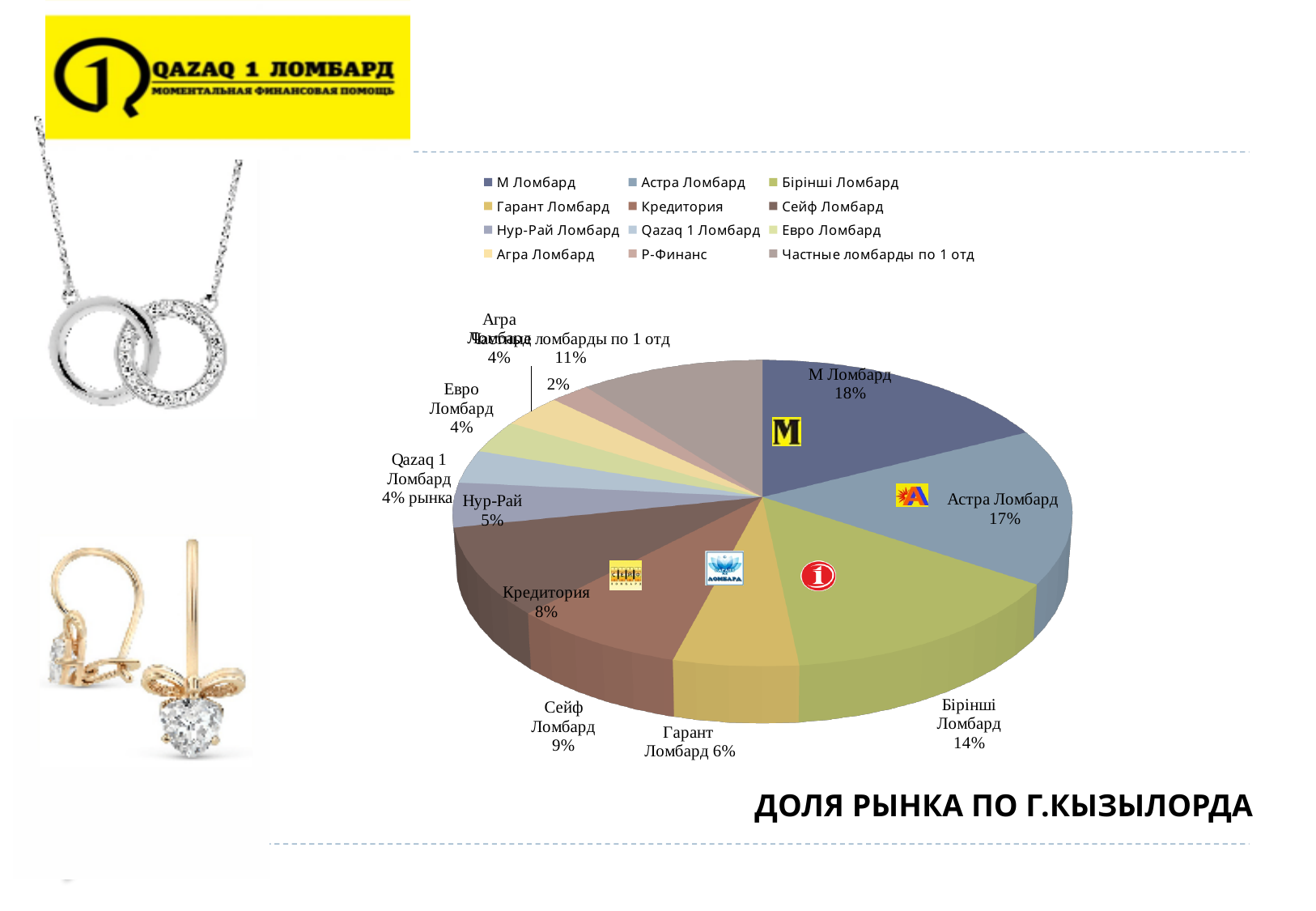
How many entries does the legend list? 12 What is the market share of Астра Ломбард? 17% What is the market share of Qazaq 1 Ломбард? 4% What is the difference in percentage points between М Ломбард and Астра Ломбард? 1 percentage point What is the difference in percentage points between Бірінші Ломбард and Гарант Ломбард? 8 percentage points What kind of chart is shown on the slide? pie chart What is the market share of Бірінші Ломбард? 14% What is the market share of М Ломбард? 18% Which has the larger share, Сейф Ломбард or Кредитория? Сейф Ломбард What share is shown for Частные ломбарды по 1 отд? 11% What is the title of the chart? ДОЛЯ РЫНКА ПО Г.КЫЗЫЛОРДА Which company has the largest share in the pie chart? М Ломбард